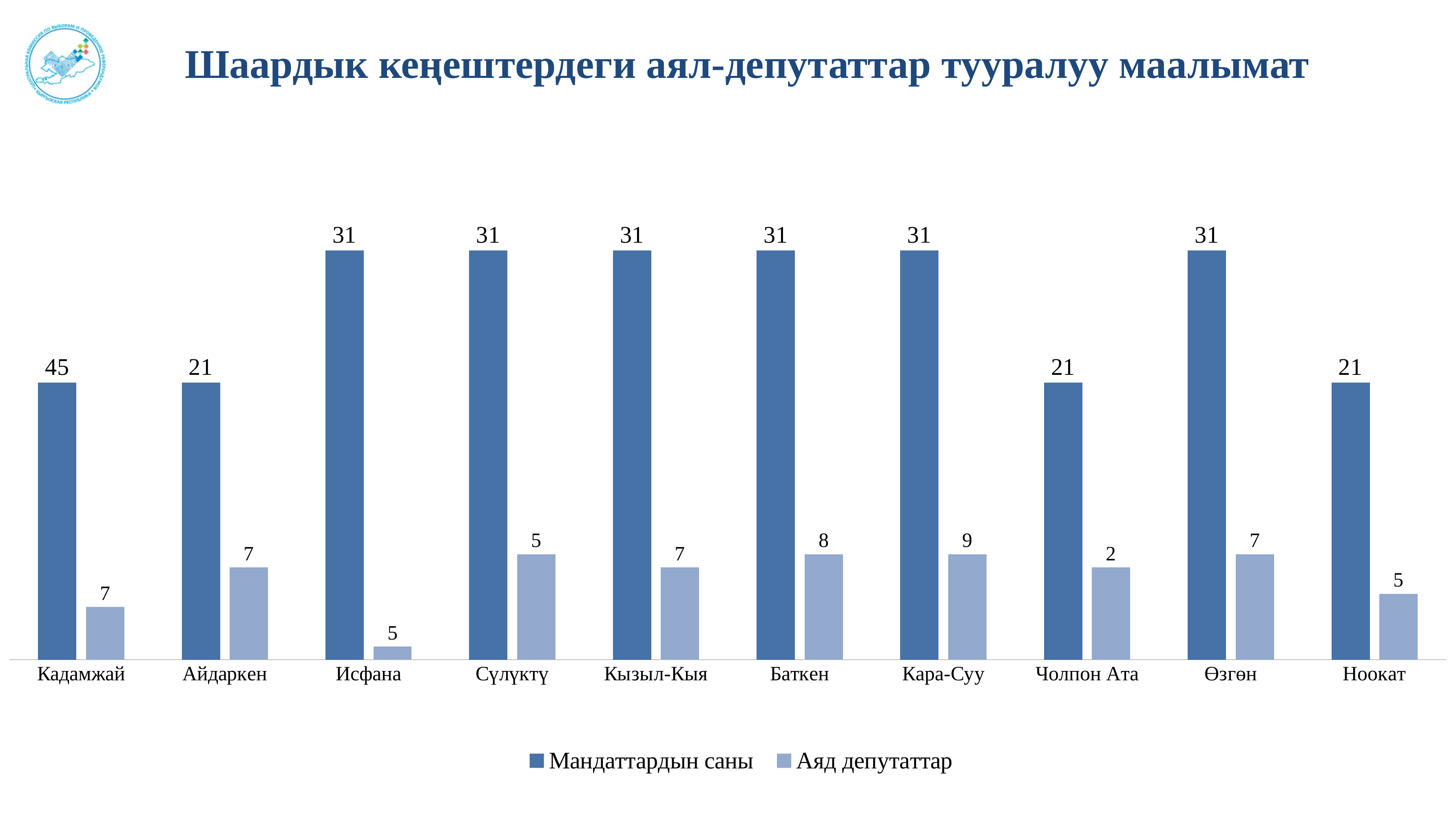
How many series does the legend list? 2 What is the value of Мандаттардын саны for Кадамжай? 45 What is the difference in Мандаттардын саны between Кадамжай and Айдаркен? 24 Which is larger: Аяд депутаттар for Баткен or for Исфана? Баткен What is the title of the chart on the slide? Шаардык кеңештердеги аял-депутаттар тууралуу маалымат How many categories are shown on the x axis? 10 What is the difference between Мандаттардын саны and Аяд депутаттар for Баткен? 23 What kind of chart is shown on the slide? bar chart What is the value of Аяд депутаттар for Чолпон Ата? 2 What is the value of Аяд депутаттар for Кара-Суу? 9